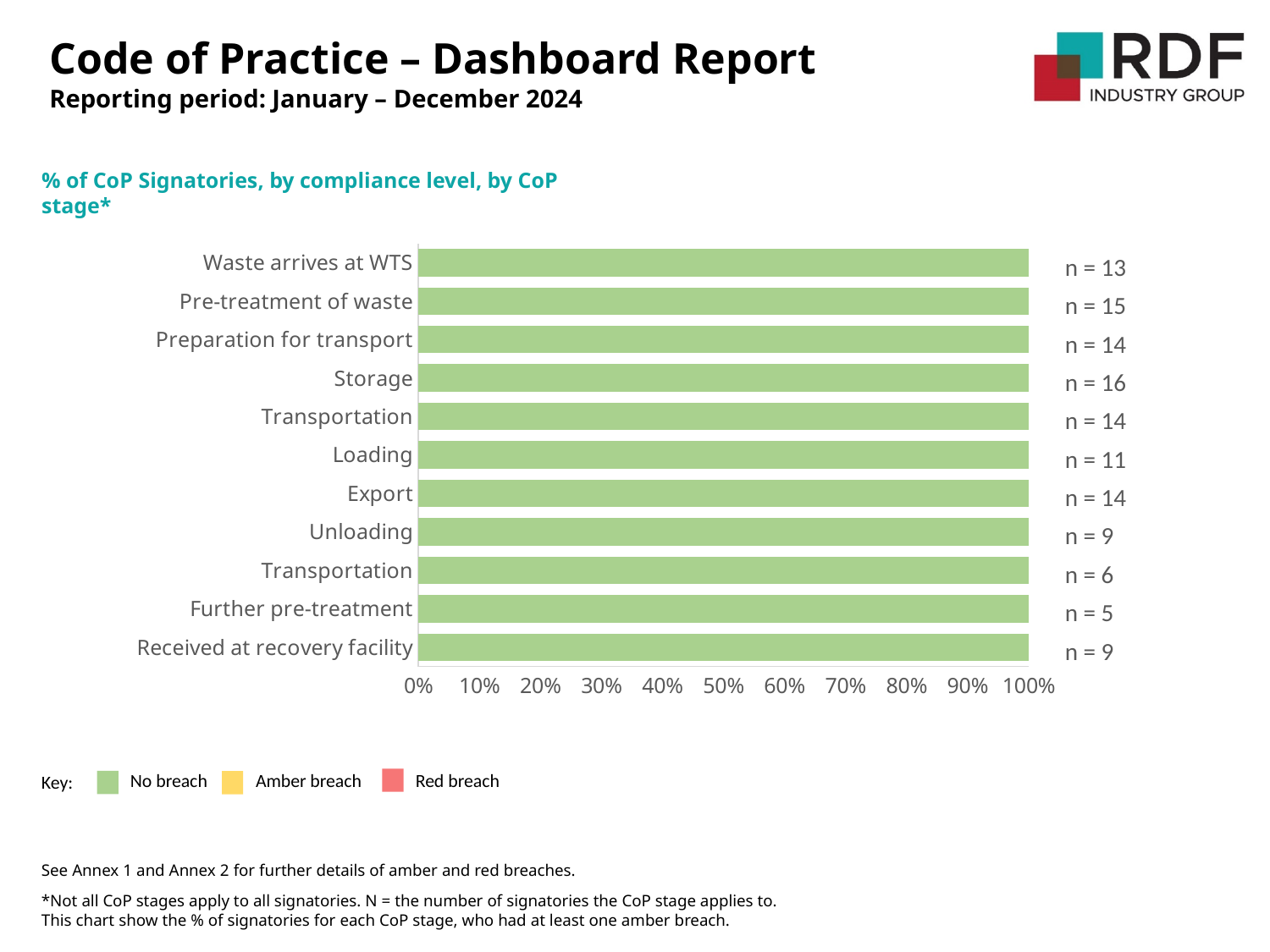
Which CoP stage has the smallest n value? Further pre-treatment What percentage does the bar for 'Export' reach on the x axis? 100% How many compliance levels does the key list? 3 What is the n value shown for the 'Loading' stage? n = 11 What is the n value shown for the 'Waste arrives at WTS' stage? n = 13 Which colour in the key represents 'No breach'? green Which CoP stage has the largest n value? Storage What is the n value shown for the 'Further pre-treatment' stage? n = 5 How many CoP stages (categories) are plotted on the chart? 11 What is the n value shown for the 'Storage' stage? n = 16 What is the difference between the n values for 'Pre-treatment of waste' and 'Unloading'? 6 What kind of chart is shown on the slide? bar chart